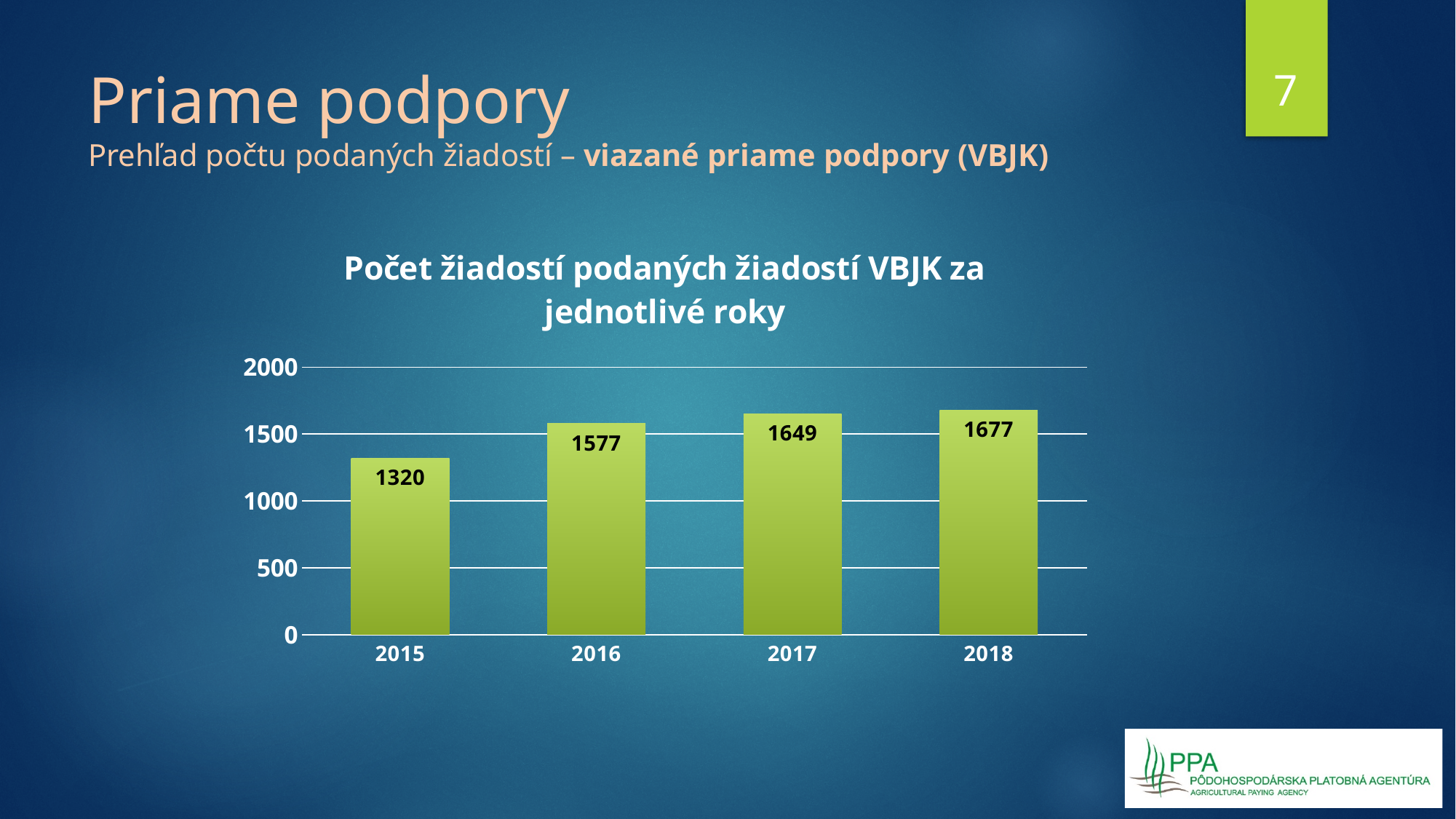
What is the difference between the values for 2016 and 2015? 257 Is the value for 2015 greater or less than 1500? less Which year has the highest value? 2018 What is the value for 2018? 1677 Which year has the lowest value? 2015 How many years are shown on the x axis? 4 What is the value for 2015? 1320 What is the value for 2017? 1649 Do the values rise or fall from 2015 to 2018? rise Which is larger, the value for 2016 or the value for 2017? 2017 What kind of chart is shown on the slide? bar chart What is the difference between the values for 2018 and 2017? 28